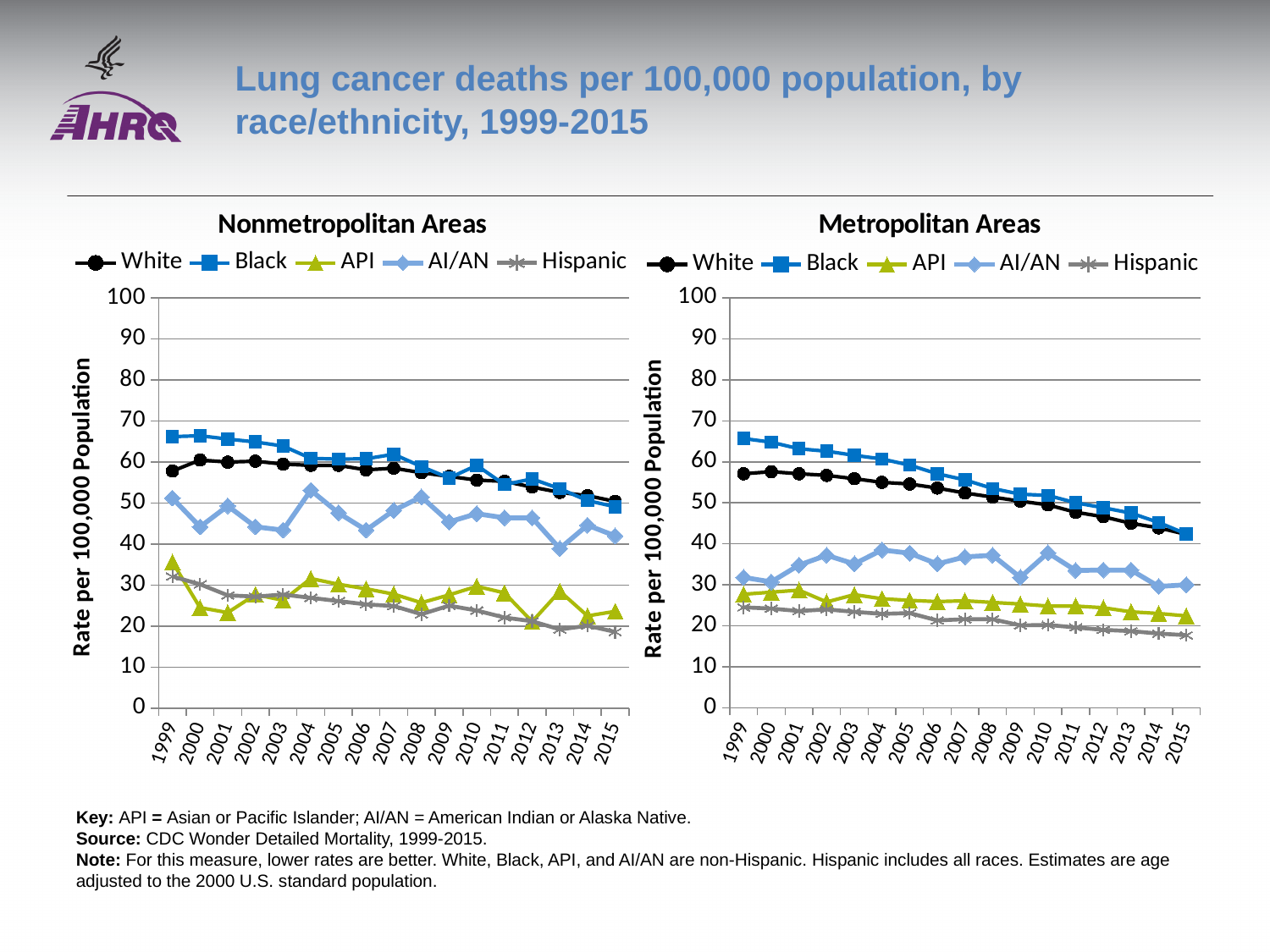
In the Metropolitan Areas chart, is the value for White in 2015 greater or less than 50? less In the Nonmetropolitan Areas chart, is the value for Black in 1999 greater or less than 60? greater In the Metropolitan Areas chart, does the Black series rise or fall from 1999 to 2015? fall In the Metropolitan Areas chart, is the value for Hispanic in 2015 greater or less than 20? less What is the y-axis title of the Metropolitan Areas chart? Rate per 100,000 Population What kind of chart is the Nonmetropolitan Areas chart? line chart How many years are plotted along the x axis of the Nonmetropolitan Areas chart? 17 In the Nonmetropolitan Areas chart, which series has the lowest value in 2013? Hispanic Which is larger in 1999: the AI/AN value in the Nonmetropolitan Areas chart or the AI/AN value in the Metropolitan Areas chart? Nonmetropolitan Areas In the Metropolitan Areas chart, which series has the highest value in 1999? Black How many series does the legend of the Metropolitan Areas chart list? 5 In the Metropolitan Areas chart, does the White series rise or fall from 1999 to 2015? fall